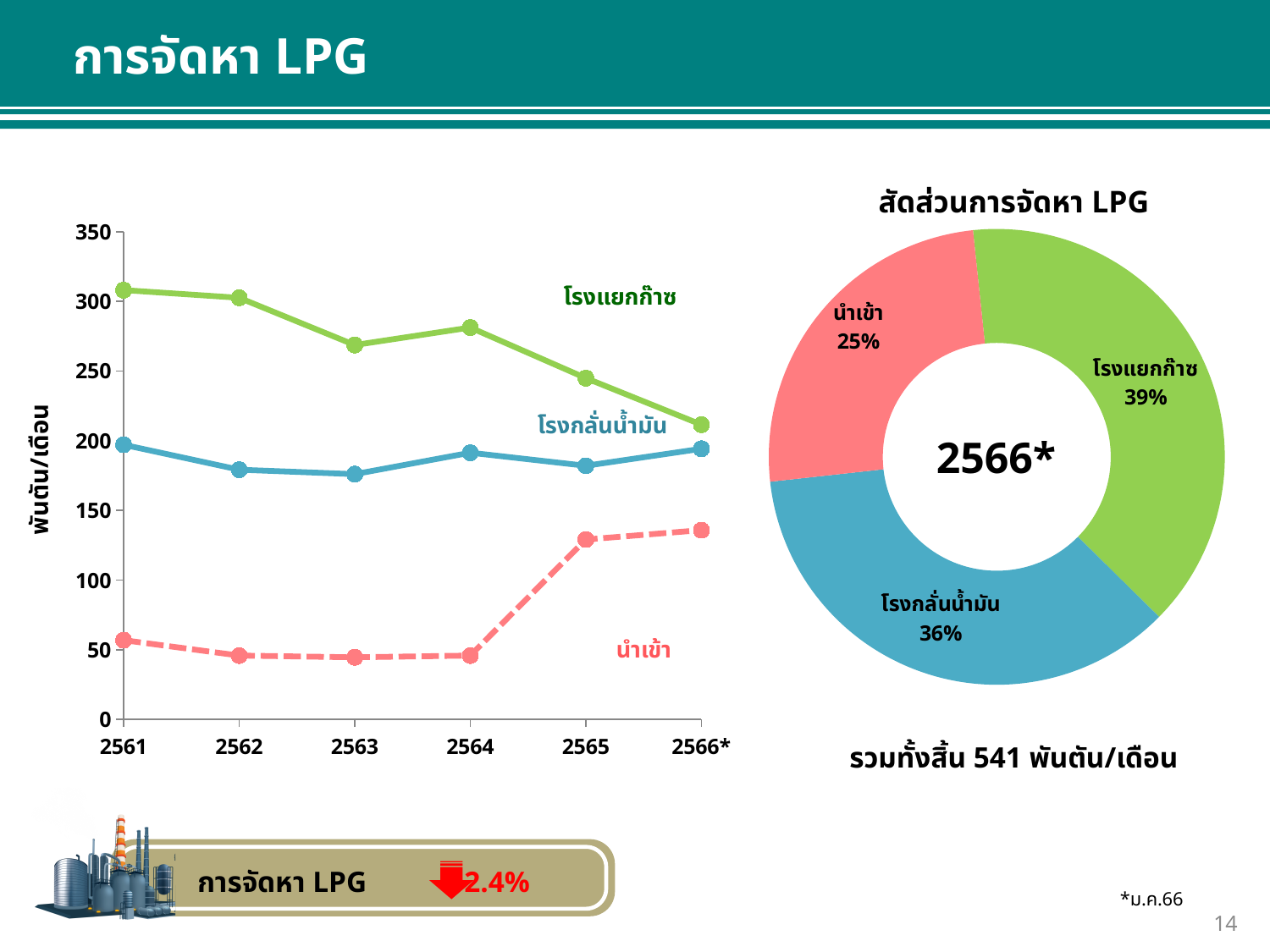
On the line chart on the left, which is larger in 2565: โรงกลั่นน้ำมัน or นำเข้า? โรงกลั่นน้ำมัน On the donut chart titled สัดส่วนการจัดหา LPG, which source has the largest share? โรงแยกก๊าซ On the donut chart titled สัดส่วนการจัดหา LPG, how many percentage points larger is the โรงแยกก๊าซ share than the นำเข้า share? 14 On the line chart on the left, how many series are plotted? 3 On the donut chart titled สัดส่วนการจัดหา LPG, what share does โรงแยกก๊าซ have? 39% On the line chart on the left, how many years are shown on the x axis? 6 On the line chart on the left, is the value for โรงแยกก๊าซ in 2561 greater or less than 300? greater On the donut chart titled สัดส่วนการจัดหา LPG, which source has the smallest share? นำเข้า On the donut chart titled สัดส่วนการจัดหา LPG, what share does โรงกลั่นน้ำมัน have? 36% On the line chart on the left, does the โรงแยกก๊าซ line generally rise or fall from 2561 to 2566*? fall On the donut chart titled สัดส่วนการจัดหา LPG, what share does นำเข้า have? 25% On the donut chart titled สัดส่วนการจัดหา LPG, what year is shown in the centre of the donut? 2566*